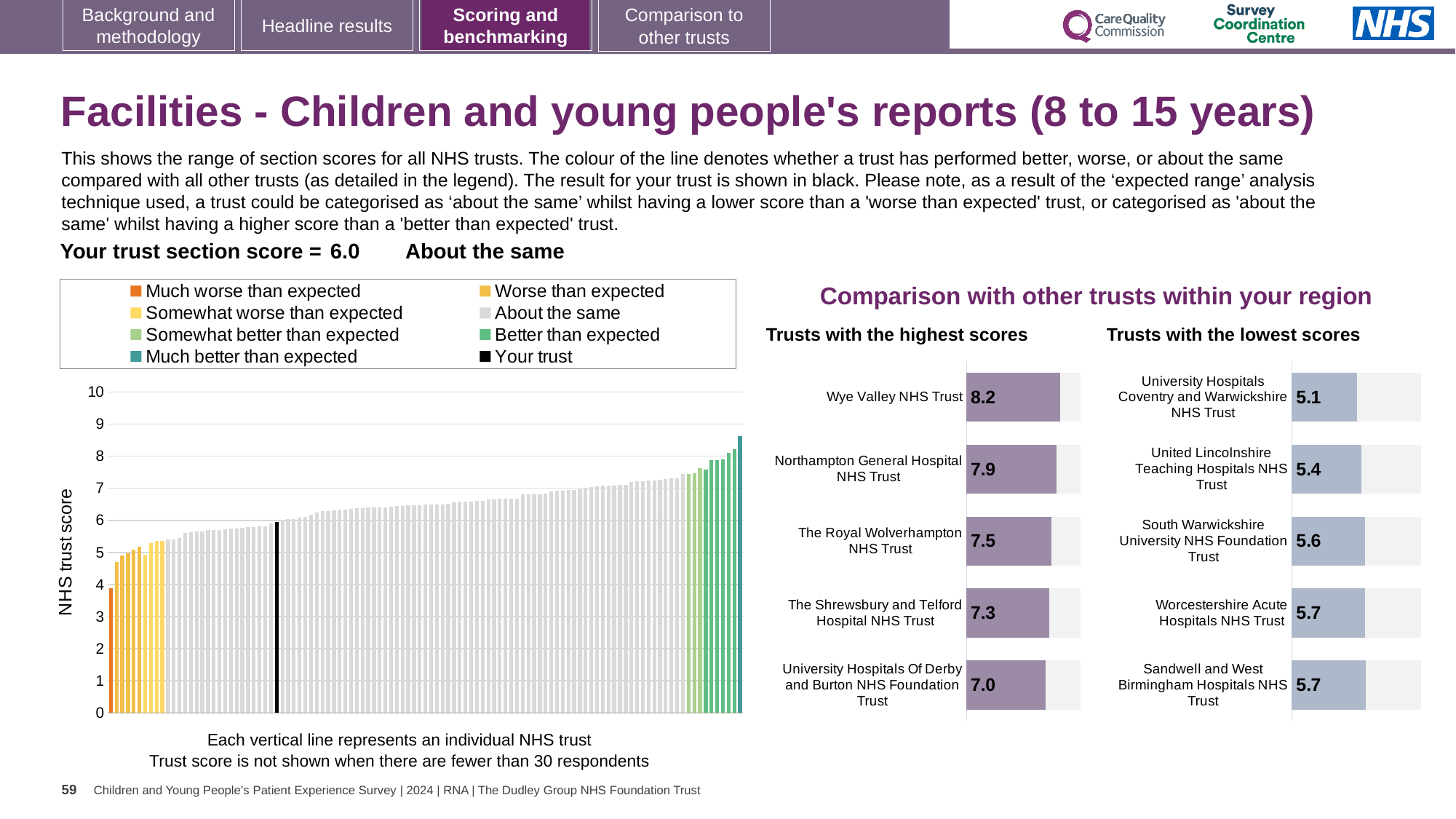
In the main chart of all NHS trusts, what is the section score for your trust (the black bar)? 6.0 In the 'Trusts with the lowest scores' chart, what is the score for United Lincolnshire Teaching Hospitals NHS Trust? 5.4 How many trusts are shown in the 'Trusts with the highest scores' chart? 5 In the 'Trusts with the highest scores' chart, what is the score for Wye Valley NHS Trust? 8.2 In the 'Trusts with the highest scores' chart, what is the score for The Royal Wolverhampton NHS Trust? 7.5 In the main chart of all NHS trusts, is the value of the tallest bar greater or less than 8? greater In the 'Trusts with the highest scores' chart, which trust has the highest score? Wye Valley NHS Trust In the 'Trusts with the highest scores' chart, what is the difference between the scores of Wye Valley NHS Trust and University Hospitals Of Derby and Burton NHS Foundation Trust? 1.2 In the 'Trusts with the lowest scores' chart, which trust has the lowest score? University Hospitals Coventry and Warwickshire NHS Trust In the 'Trusts with the lowest scores' chart, which has the higher score: South Warwickshire University NHS Foundation Trust or United Lincolnshire Teaching Hospitals NHS Trust? South Warwickshire University NHS Foundation Trust In the main chart of all NHS trusts, do the bar values rise or fall from left to right? rise How many entries does the legend of the main chart of all NHS trusts list? 8